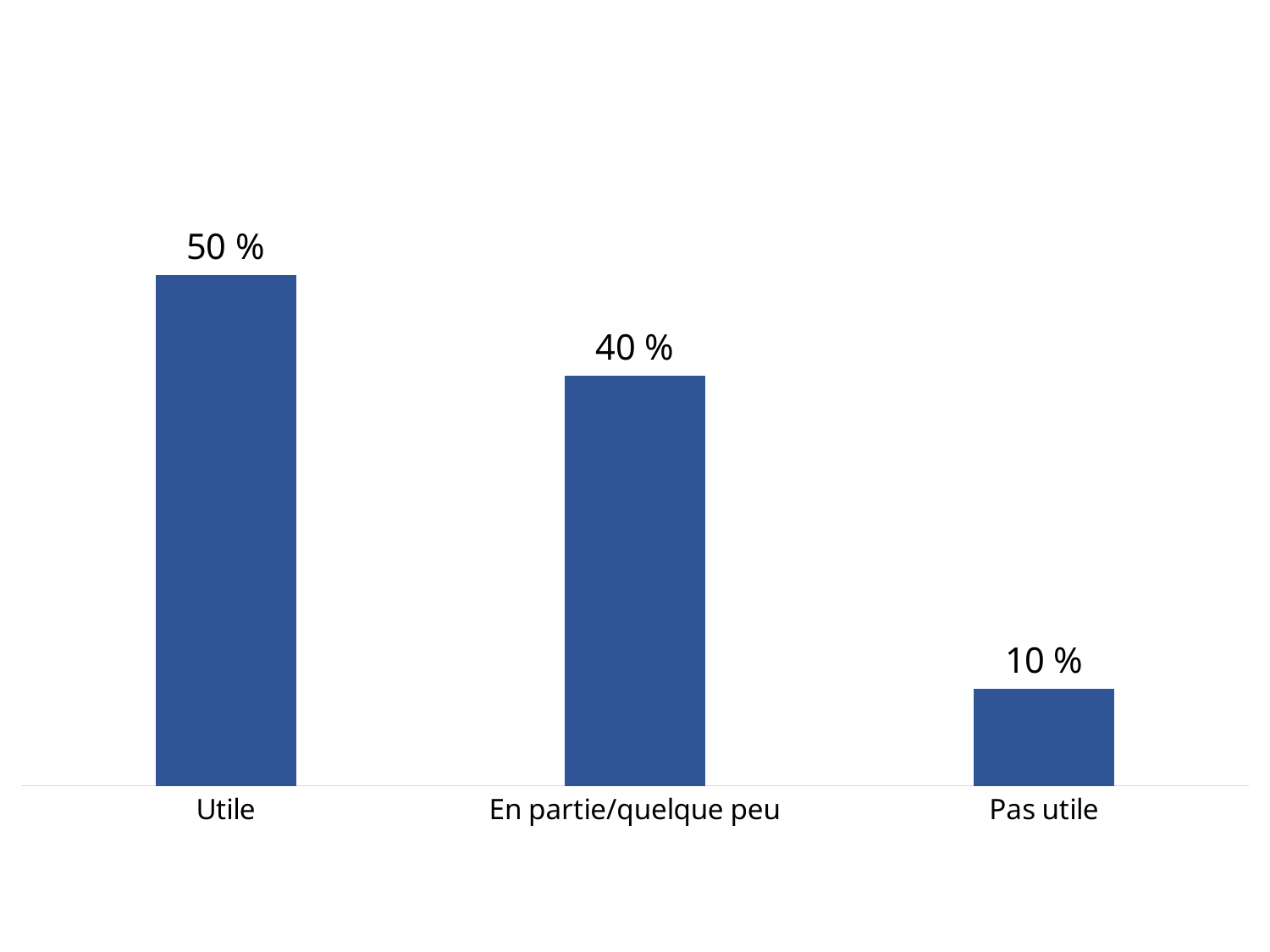
What kind of chart is shown on the slide? Bar chart How many categories are shown in the chart? 3 Do the values rise or fall from left to right across the categories? Fall What is the value for Utile? 50 % What is the value for En partie/quelque peu? 40 % Which category has the highest value? Utile What colour are the bars in the chart? Blue What is the value for Pas utile? 10 % What is the difference between the values for Utile and Pas utile? 40 % Which is larger, the value for En partie/quelque peu or the value for Pas utile? En partie/quelque peu Which category has the lowest value? Pas utile What is the difference between the values for Utile and En partie/quelque peu? 10 %